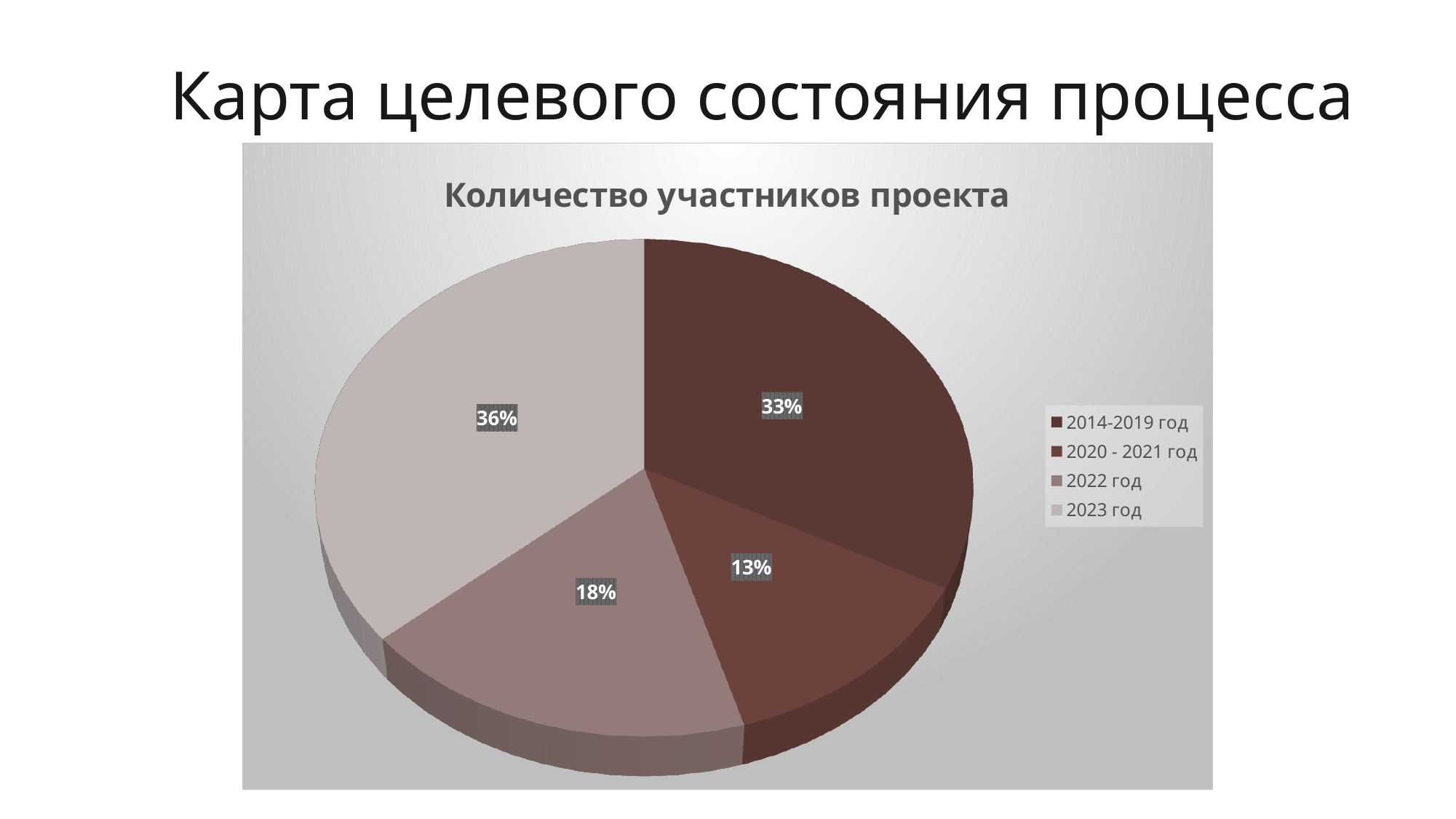
How many slices does the pie chart have? 4 What share of the pie does the 2023 год slice represent? 36% How many entries does the legend list? 4 What share of the pie does the 2014-2019 год slice represent? 33% What kind of chart is shown on the slide? Pie chart What share of the pie does the 2020 - 2021 год slice represent? 13% What is the title of the chart? Количество участников проекта Which category has the largest slice of the pie? 2023 год Which slice is larger, 2014-2019 год or 2022 год? 2014-2019 год Which category has the smallest slice of the pie? 2020 - 2021 год What is the difference in percentage points between the 2023 год slice and the 2022 год slice? 18